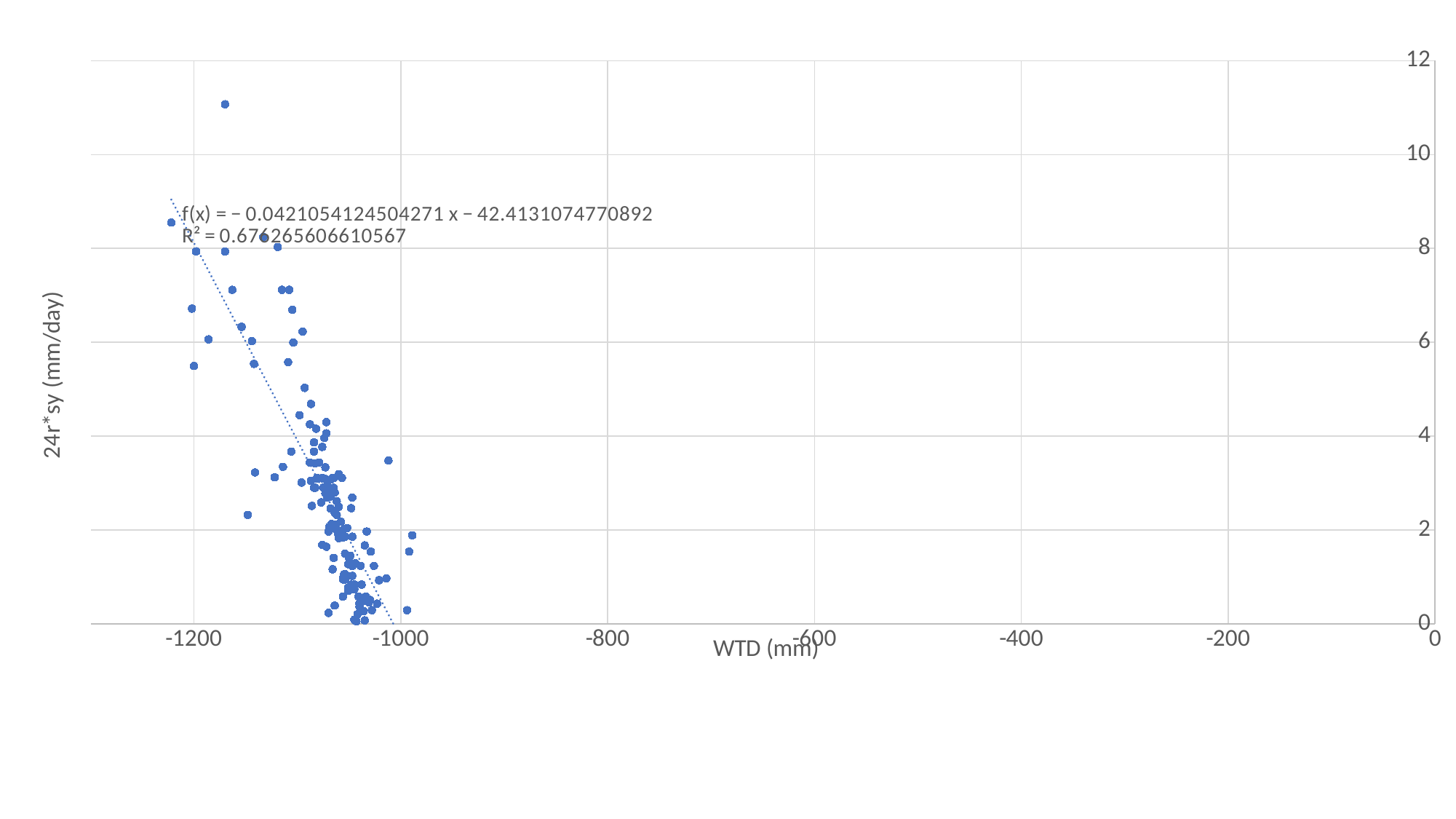
What kind of chart is shown on the slide? scatter plot Are all plotted points at WTD values greater or less than -800? less What is the maximum value shown on the y axis? 12 Is the highest plotted 24r*sy value greater or less than 10? greater What is the label of the y axis? 24r*sy (mm/day) What is the label of the x axis? WTD (mm) What is the slope coefficient in the trendline equation f(x) shown on the chart? −0.0421054124504271 Is the lowest plotted 24r*sy value greater or less than 2? less As WTD increases along the x axis, do the plotted 24r*sy values generally rise or fall? fall What is the intercept in the trendline equation f(x) shown on the chart? −42.4131074770892